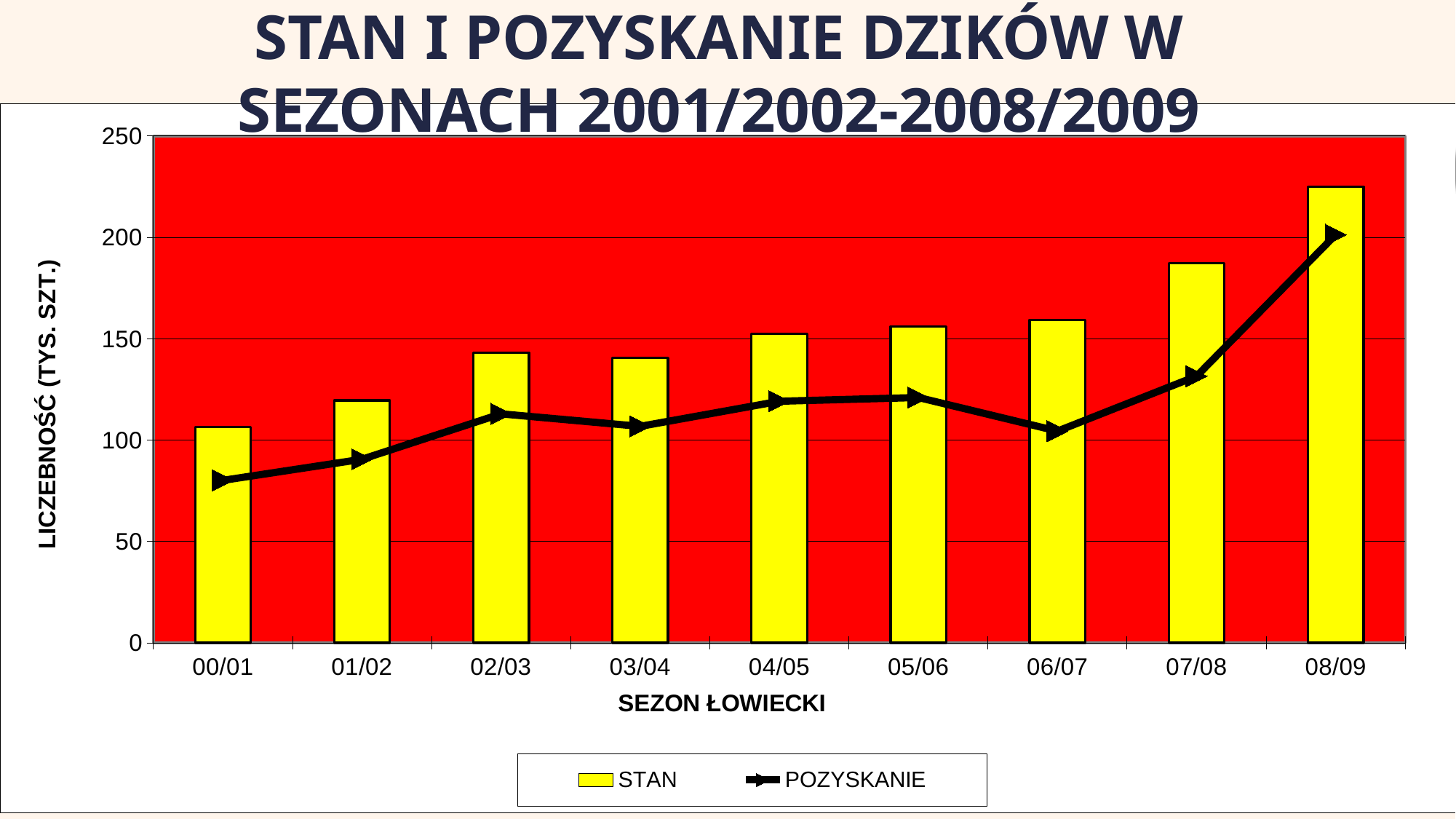
Which season has the larger STAN value, 06/07 or 07/08? 07/08 In which season does the POZYSKANIE line reach its highest point? 08/09 How many seasons are shown on the x axis? 9 What kind of chart is shown on the slide? A combined bar and line chart In which season is the STAN bar the highest? 08/09 Is the STAN value for 07/08 greater or less than 200? less What is the title of the x axis? SEZON ŁOWIECKI In which season is the STAN bar the lowest? 00/01 Does the STAN series generally rise or fall from 00/01 to 08/09? rise In which season is the POZYSKANIE value the lowest? 00/01 Is the POZYSKANIE value for 00/01 greater or less than 100? less How many series does the legend list? 2